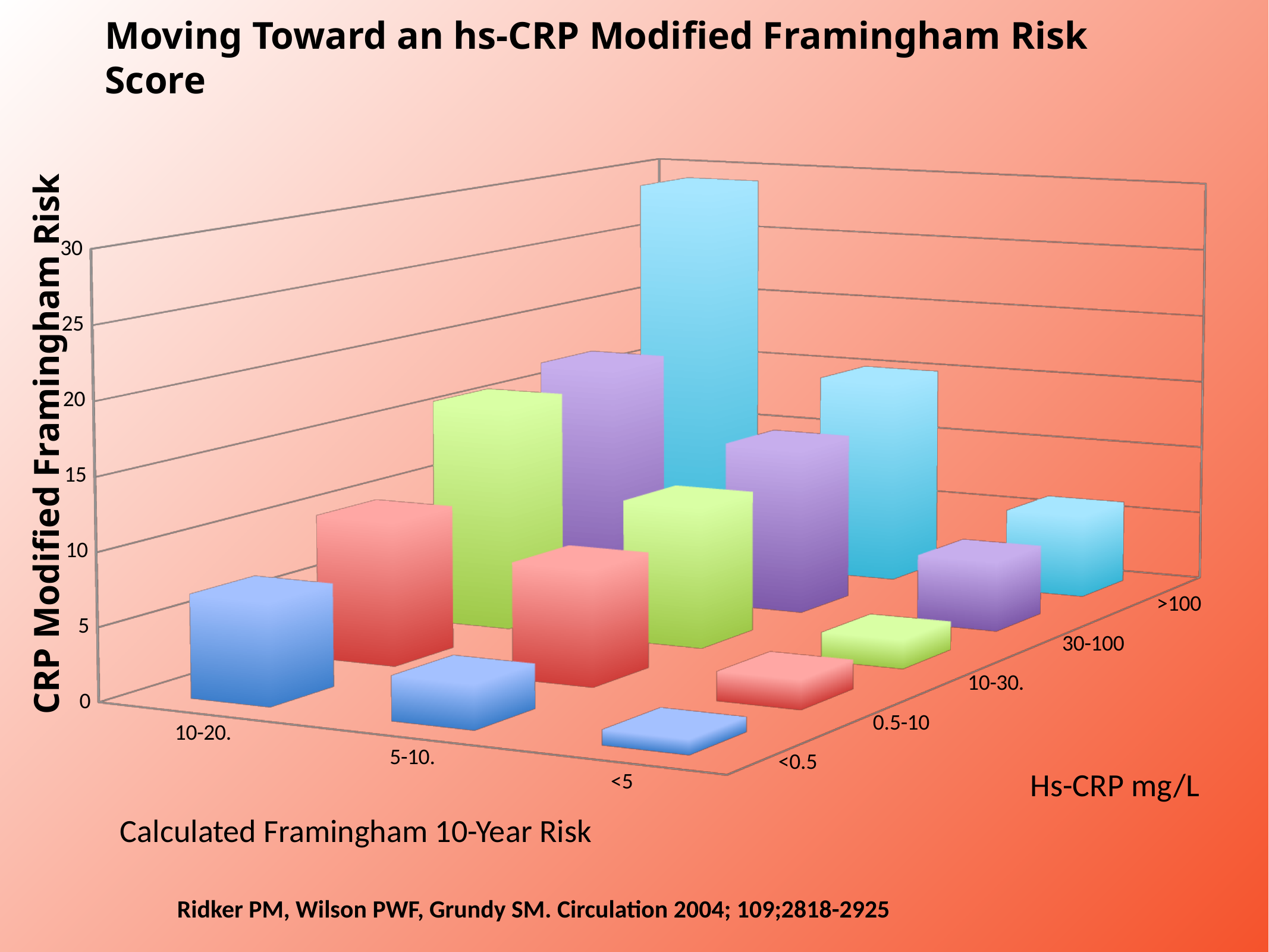
What is the title of the vertical axis of the chart? CRP Modified Framingham Risk Is the CRP Modified Framingham Risk for the <5 risk group with Hs-CRP 0.5-10 greater or less than 5? less Within the 10-20 Calculated Framingham 10-Year Risk group, which has the larger CRP Modified Framingham Risk: Hs-CRP <0.5 or Hs-CRP >100? Hs-CRP >100 Within the 10-20 Calculated Framingham 10-Year Risk group, does the CRP Modified Framingham Risk rise or fall as Hs-CRP increases from <0.5 to >100? rise What kind of chart is shown on the slide? bar chart How many Calculated Framingham 10-Year Risk categories are shown on the chart? 3 Is the CRP Modified Framingham Risk for the <5 risk group with Hs-CRP <0.5 greater or less than 5? less Within the Hs-CRP >100 group, which has the larger CRP Modified Framingham Risk: the 10-20 risk group or the 5-10 risk group? 10-20 Is the CRP Modified Framingham Risk for the 10-20 risk group with Hs-CRP >100 greater or less than 20? greater How many Hs-CRP mg/L categories are shown on the chart? 5 Which combination of Calculated Framingham 10-Year Risk and Hs-CRP level has the lowest CRP Modified Framingham Risk? <5 risk with Hs-CRP <0.5 Which combination of Calculated Framingham 10-Year Risk and Hs-CRP level has the highest CRP Modified Framingham Risk? 10-20 risk with Hs-CRP >100